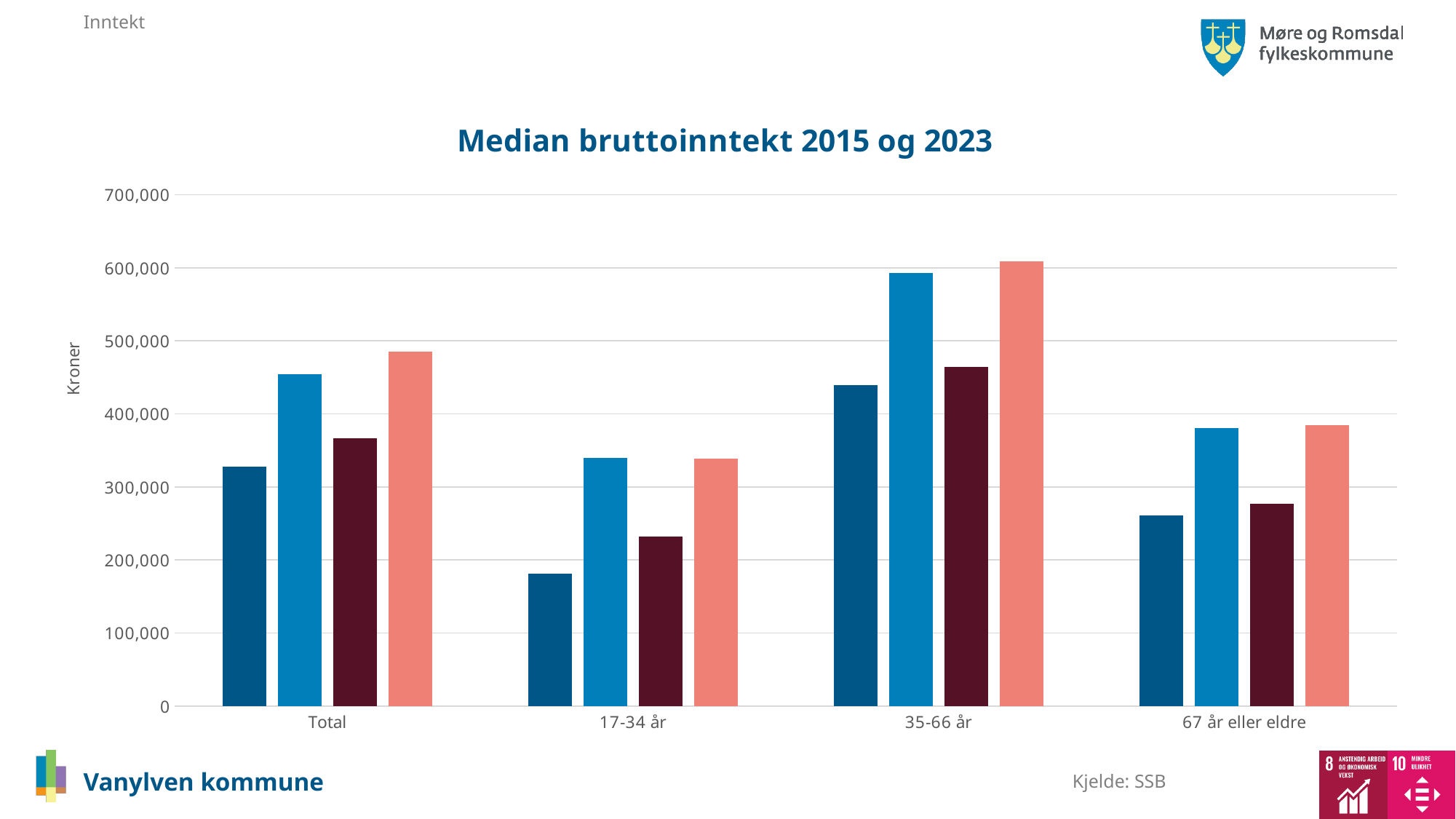
Which is larger: the dark red (third) bar for Total or the dark red (third) bar for 35-66 år? 35-66 år Which category has the tallest bars in the chart? 35-66 år What is the label on the vertical axis of the chart? Kroner Which category contains the lowest bar in the chart? 17-34 år How many bars are plotted for each category in the chart? 4 Is the value of the light blue (second) bar for 35-66 år greater or less than 500,000? greater What is the title of the chart? Median bruttoinntekt 2015 og 2023 Is the value of the dark red (third) bar for 67 år eller eldre greater or less than 300,000? less Is the value of the dark blue (first) bar for 17-34 år greater or less than 200,000? less How many categories are shown on the x axis of the chart? 4 What kind of chart is shown on the slide? bar chart